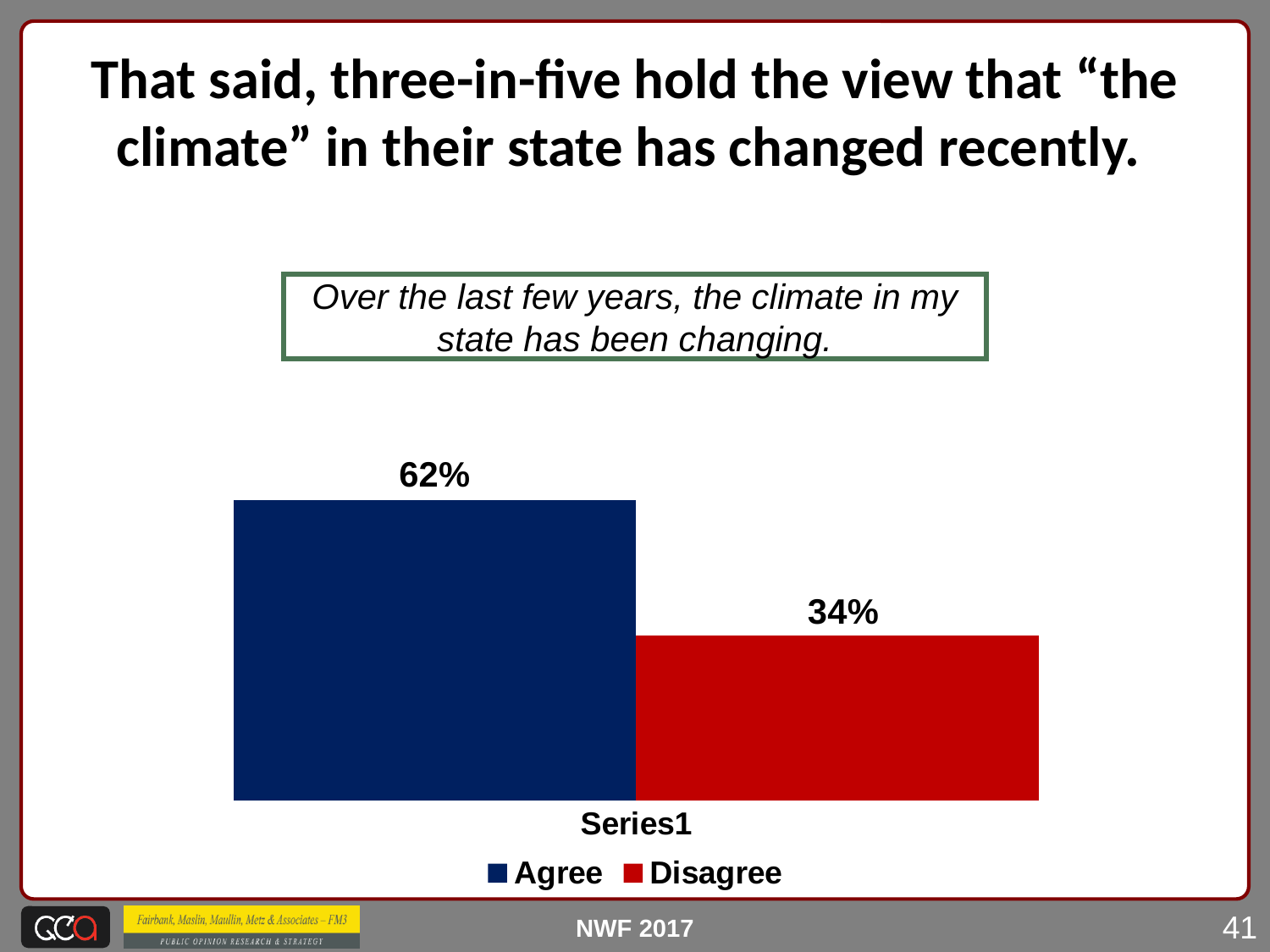
What kind of chart is shown on the slide? bar chart Is the value for Disagree larger or smaller than the value for Agree? smaller What percentage of respondents agree that the climate in their state has been changing? 62% How many series does the legend list? 2 How many bars are plotted in the chart? 2 What percentage of respondents disagree that the climate in their state has been changing? 34% What is the difference in percentage points between Agree and Disagree? 28 What colour is the Agree bar? dark blue Which response has the lower value, Agree or Disagree? Disagree Which response has the higher value, Agree or Disagree? Agree What statement were respondents asked to agree or disagree with, as shown in the box above the chart? Over the last few years, the climate in my state has been changing.